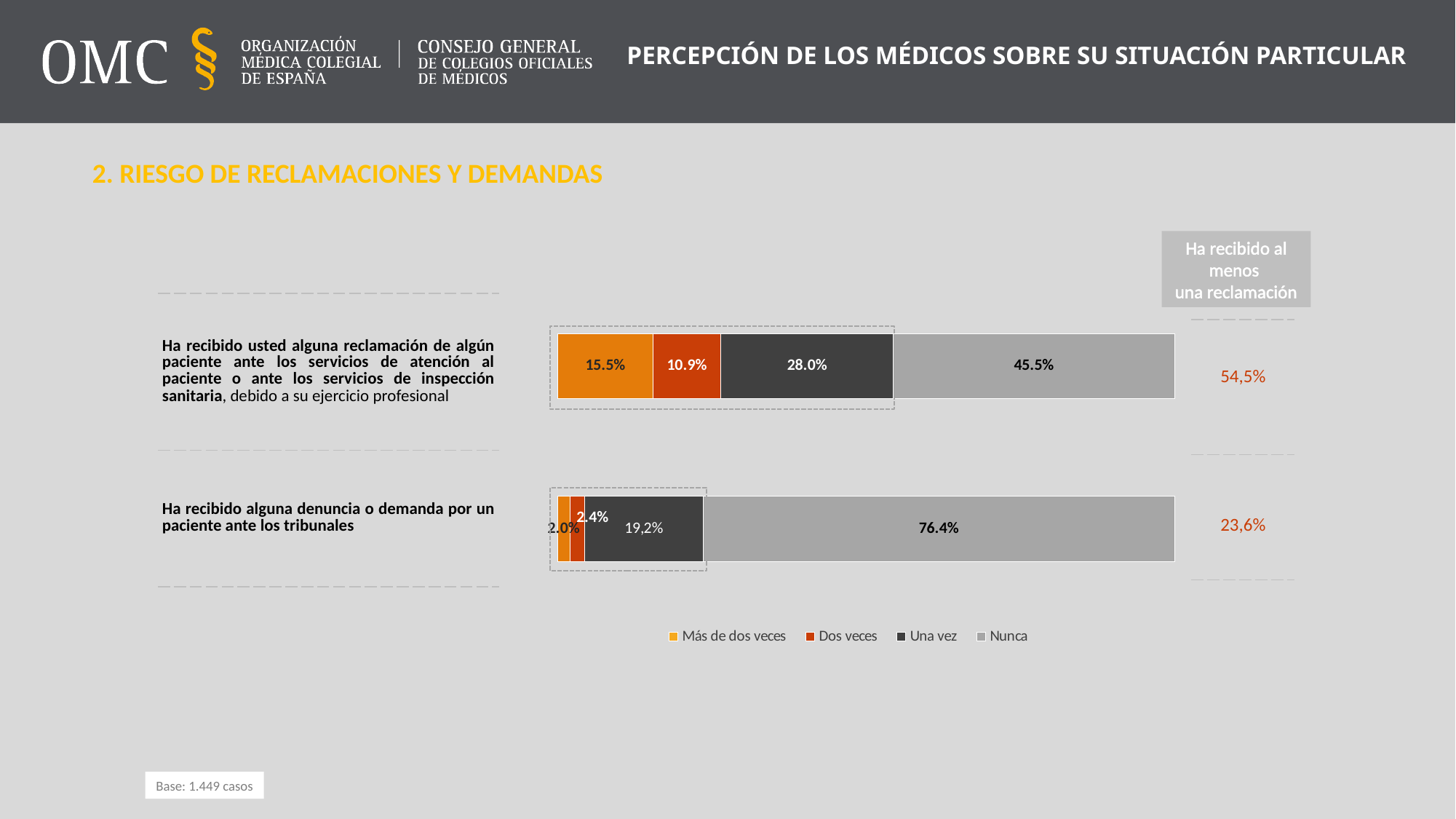
What are the four legend entries of the chart? Más de dos veces, Dos veces, Una vez, Nunca Is the 'Nunca' value larger for the reclamación bar or for the denuncia o demanda bar? Denuncia o demanda bar How many questions (bars) are plotted in the chart? 2 What is the value for 'Más de dos veces' in the bar about receiving a reclamación from a patient? 15.5% How many series does the legend list? 4 What is the difference between the 'Nunca' and 'Una vez' values in the bar about receiving a reclamación from a patient? 17.5 percentage points What kind of chart is shown on the slide? Stacked bar chart What is the value for 'Una vez' in the bar about receiving a denuncia o demanda ante los tribunales? 19,2% What is the value for 'Dos veces' in the bar about receiving a denuncia o demanda ante los tribunales? 2.4% Which series has the largest segment in the bar about receiving a denuncia o demanda ante los tribunales? Nunca What percentage is shown under 'Ha recibido al menos una reclamación' for the bar about receiving a reclamación from a patient? 54,5% What is the value for 'Nunca' in the bar about receiving a reclamación from a patient? 45.5%